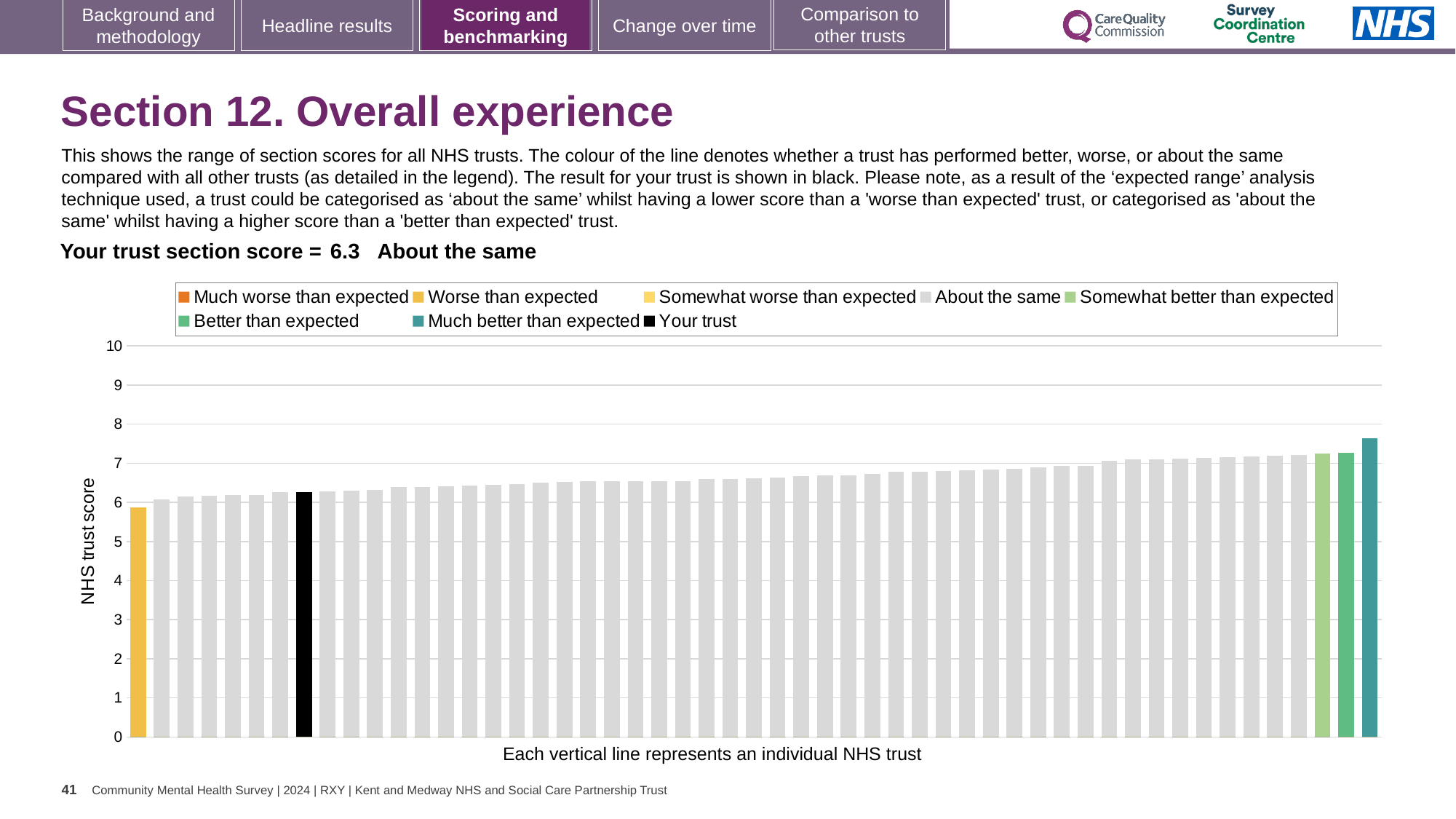
What kind of chart is shown on the slide? bar chart How many entries does the chart legend list? 8 What is the section score for your trust shown on the slide? 6.3 Which legend category does the lowest bar on the chart belong to? Worse than expected Is the value of the leftmost (yellow) bar greater or less than 7? less Do the bar values rise or fall from left to right along the x axis? rise Is the value for your trust greater or less than 5? greater Is the value of the tallest bar (the rightmost, teal bar) greater or less than 7? greater What colour is the bar representing your trust? black Which legend category does the highest bar on the chart belong to? Much better than expected Which benchmarking category is your trust placed in for Section 12? About the same